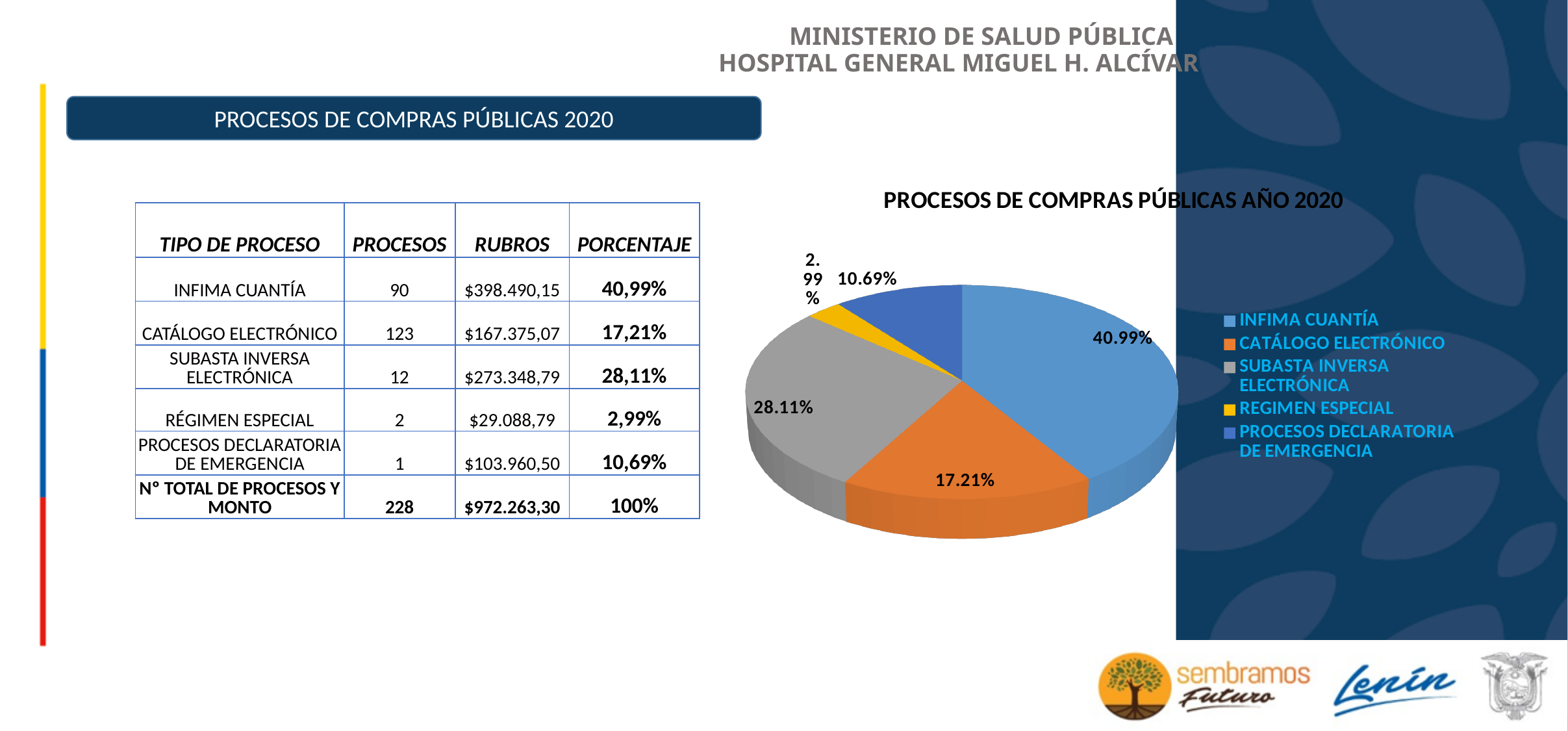
What share of the pie does CATÁLOGO ELECTRÓNICO represent? 17.21% What is the title of the pie chart? PROCESOS DE COMPRAS PÚBLICAS AÑO 2020 Which category has the largest slice of the pie chart? INFIMA CUANTÍA How many entries does the pie chart's legend list? 5 What share of the pie does REGIMEN ESPECIAL represent? 2.99% How many slices does the pie chart have? 5 What share of the pie does INFIMA CUANTÍA represent? 40.99% Which category has the smallest slice of the pie chart? REGIMEN ESPECIAL Which slice is larger in the pie chart, SUBASTA INVERSA ELECTRÓNICA or CATÁLOGO ELECTRÓNICO? SUBASTA INVERSA ELECTRÓNICA What kind of chart is shown on the slide? pie chart